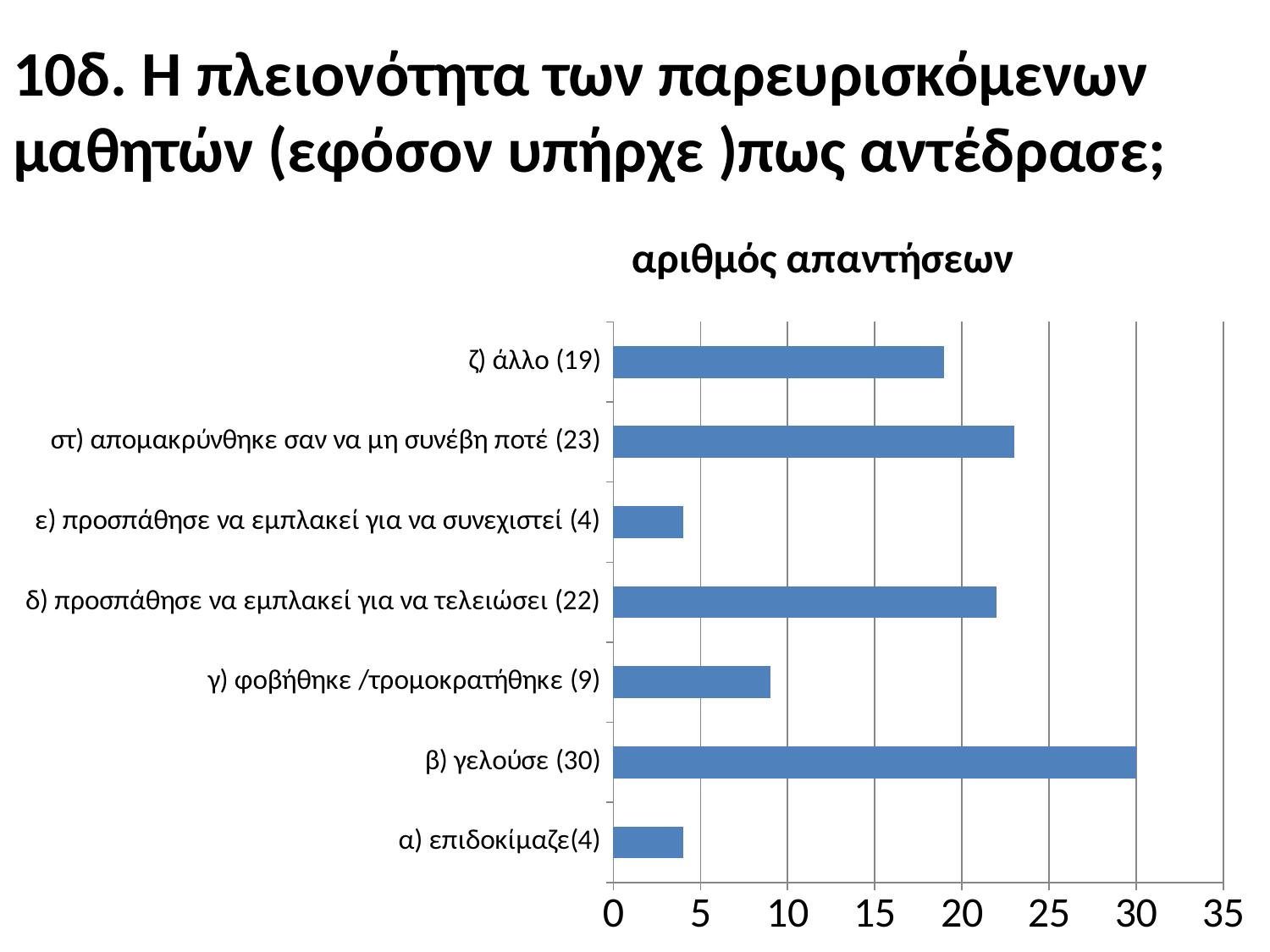
What is the title of the chart? αριθμός απαντήσεων What kind of chart is shown on the slide? bar chart What is the maximum value shown on the horizontal axis? 35 What is the value for the category 'στ) απομακρύνθηκε σαν να μη συνέβη ποτέ'? 23 Which is larger, the value for 'στ) απομακρύνθηκε σαν να μη συνέβη ποτέ' or the value for 'δ) προσπάθησε να εμπλακεί για να τελειώσει'? στ) απομακρύνθηκε σαν να μη συνέβη ποτέ What is the value for the category 'β) γελούσε'? 30 How many categories does the chart show? 7 Is the value for 'ζ) άλλο' greater or less than 20? less What is the difference between the values for 'β) γελούσε' and 'ζ) άλλο'? 11 Which category has the highest value? β) γελούσε (30) Is the value for 'δ) προσπάθησε να εμπλακεί για να τελειώσει' greater or less than 20? greater What is the value for the category 'γ) φοβήθηκε /τρομοκρατήθηκε'? 9